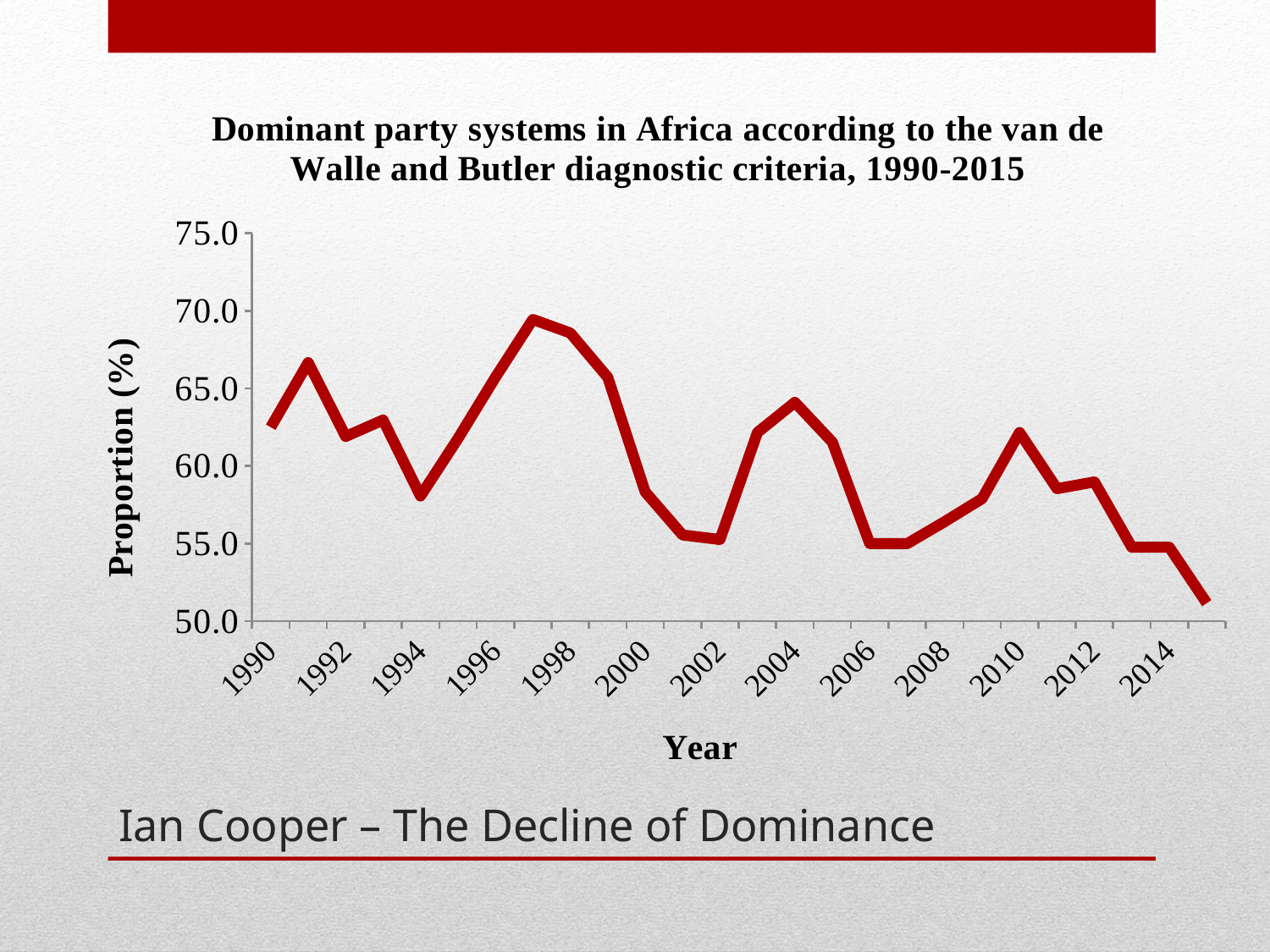
What kind of chart is shown on the slide? line chart In which year does the line reach its lowest value? 2015 In which year does the line reach its highest value? 1997 Which year has the larger value, 1997 or 2015? 1997 Is the value for 1994 greater or less than 60.0? less Overall, does the proportion rise or fall from 1990 to 2015? fall Is the value for 2015 greater or less than 55.0? less What is the label of the vertical axis? Proportion (%) Is the value for 1997 greater or less than 65.0? greater What is the title of the chart? Dominant party systems in Africa according to the van de Walle and Butler diagnostic criteria, 1990-2015